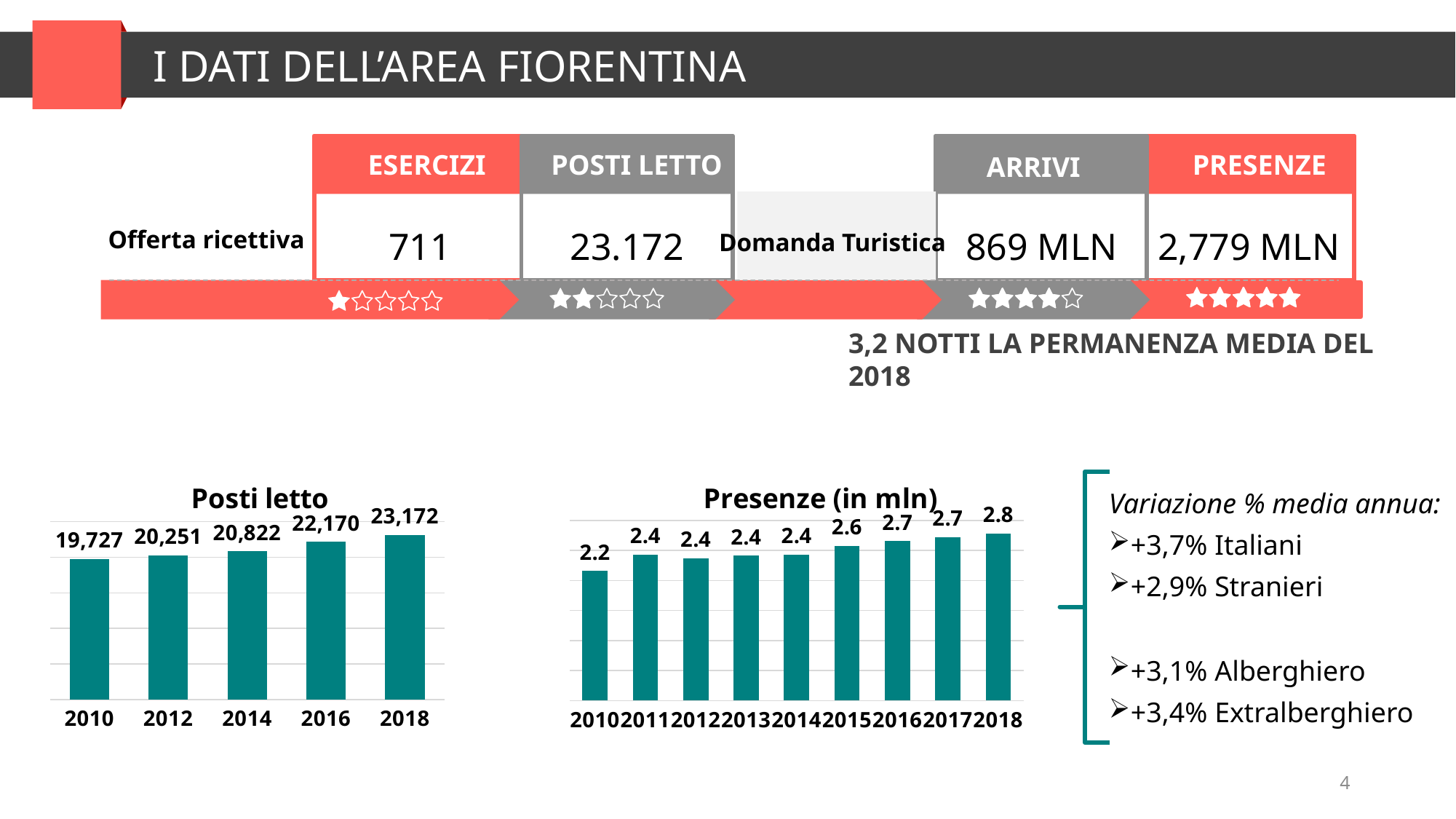
In the 'Presenze (in mln)' chart, what is the value for 2010? 2.2 In the 'Posti letto' chart, what is the difference between the 2018 and 2010 values? 3,445 In the 'Presenze (in mln)' chart, which year has the highest value? 2018 How many years are shown in the 'Presenze (in mln)' chart? 9 In the 'Posti letto' chart, which year has the lowest value? 2010 In the 'Posti letto' chart, do the values rise or fall from 2010 to 2018? rise How many bars are shown in the 'Posti letto' chart? 5 In the 'Posti letto' chart, what is the value for 2014? 20,822 In the 'Presenze (in mln)' chart, what is the value for 2015? 2.6 In the 'Posti letto' chart, what is the value for 2018? 23,172 What kind of chart is the 'Presenze (in mln)' chart? bar chart In the 'Presenze (in mln)' chart, which is larger, the value for 2016 or the value for 2010? 2016